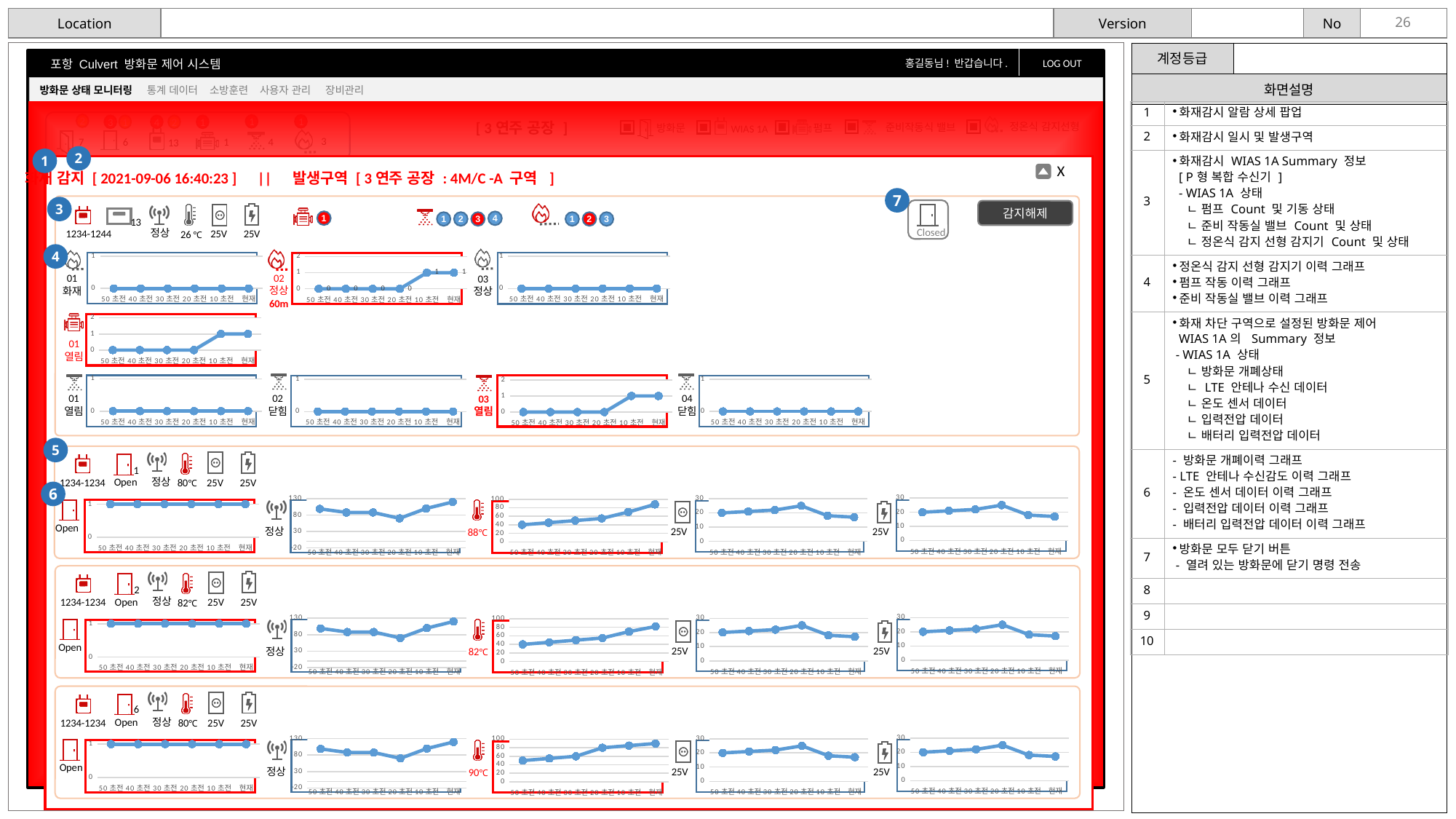
What is the highest y-axis tick shown on the temperature charts in the door rows? 100 In the red-bordered '02 정상' chart in the upper panel, what is the labelled value at 50 초전? 0 In the '02 정상' chart in the upper panel, what is the difference between the value at 현재 and the value at 50 초전? 1 In the first door row (door 1), is the LTE signal (정상) chart value at 현재 greater or less than 30? greater How many time points are plotted along the x axis of the '02 정상' chart in the upper panel? 6 In the first door row (door 1, 80℃), is the temperature chart value at 50 초전 greater or less than 60? less What is the first x-axis label shown on the history charts? 50 초전 In the first door row (door 1), does the temperature chart rise or fall overall from 50 초전 to 현재? rise In the first door row (door 1, 80℃), is the temperature chart value at 현재 greater or less than 60? greater In the red-bordered '02 정상' chart in the upper panel, what is the labelled value at 현재? 1 In the '02 정상' chart in the upper panel, do the values rise or fall from 50 초전 to 현재? rise What kind of chart is used for the '02 정상' sensor history in the upper panel? line chart